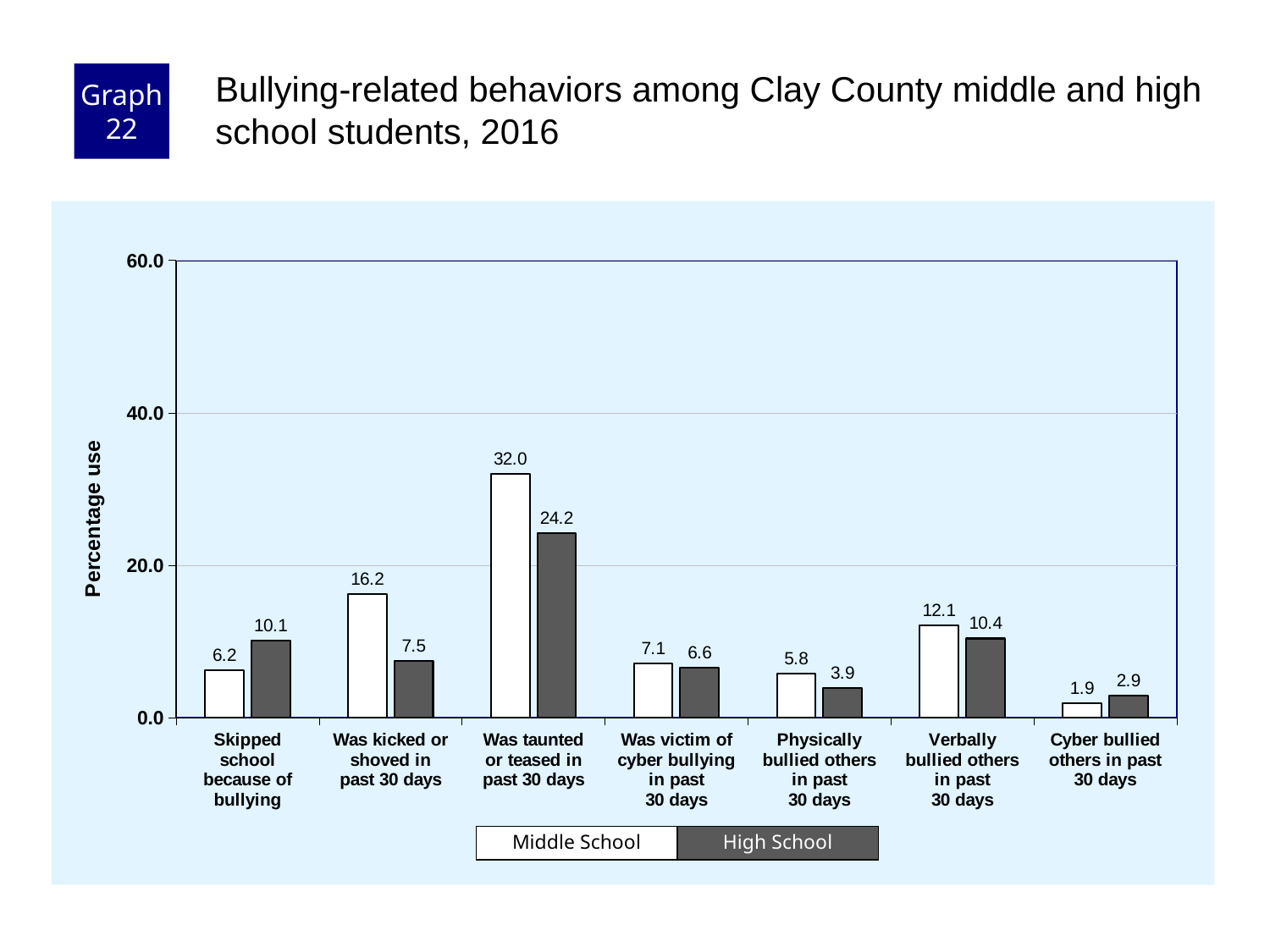
Which category has the highest Middle School value? Was taunted or teased in past 30 days For "Verbally bullied others in past 30 days", which is larger: the Middle School value or the High School value? Middle School What is the label of the y axis? Percentage use Is the High School value for "Was taunted or teased in past 30 days" greater or less than 20.0? greater How many behavior categories are shown on the x axis? 7 What is the High School value for "Skipped school because of bullying"? 10.1 How many series does the legend list? 2 Which category has the lowest High School value? Cyber bullied others in past 30 days What is the difference between the Middle School and High School values for "Was kicked or shoved in past 30 days"? 8.7 What is the Middle School value for "Was taunted or teased in past 30 days"? 32.0 What kind of chart is shown on the slide? Bar chart What is the High School value for "Cyber bullied others in past 30 days"? 2.9